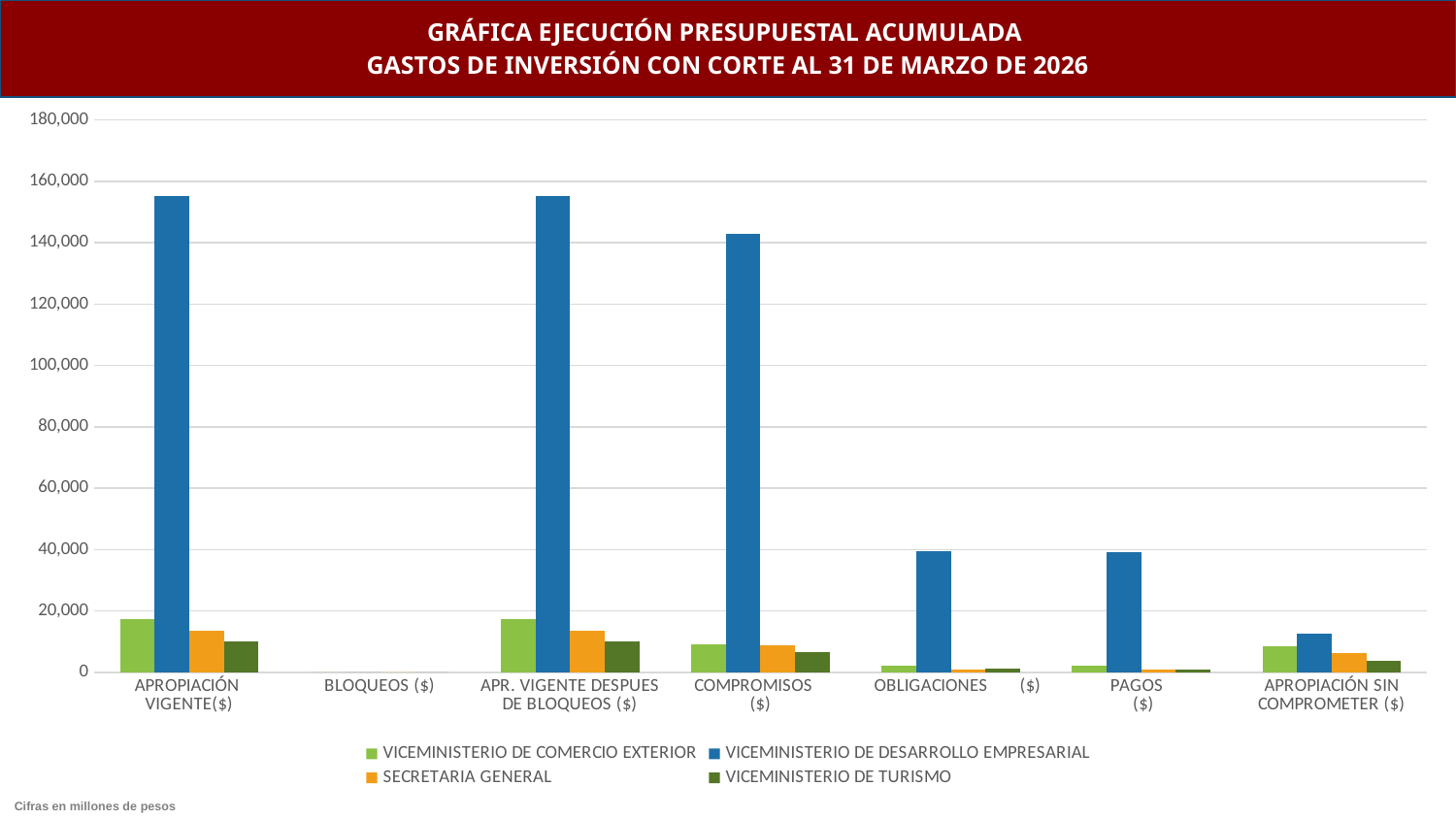
Which category has the lowest values across all series? BLOQUEOS ($) In APROPIACIÓN VIGENTE($), which is larger: VICEMINISTERIO DE COMERCIO EXTERIOR or SECRETARIA GENERAL? VICEMINISTERIO DE COMERCIO EXTERIOR Which series has the highest value in the COMPROMISOS ($) category? VICEMINISTERIO DE DESARROLLO EMPRESARIAL How many series does the legend list? 4 What kind of chart is shown on the slide? bar chart Is the value for VICEMINISTERIO DE COMERCIO EXTERIOR in APROPIACIÓN VIGENTE($) greater or less than 20,000? less Is the value for VICEMINISTERIO DE DESARROLLO EMPRESARIAL in COMPROMISOS ($) greater or less than 120,000? greater Which series is shown in dark blue in the legend? VICEMINISTERIO DE DESARROLLO EMPRESARIAL Is the value for VICEMINISTERIO DE DESARROLLO EMPRESARIAL in OBLIGACIONES ($) greater or less than 20,000? greater How many categories are shown along the x axis? 7